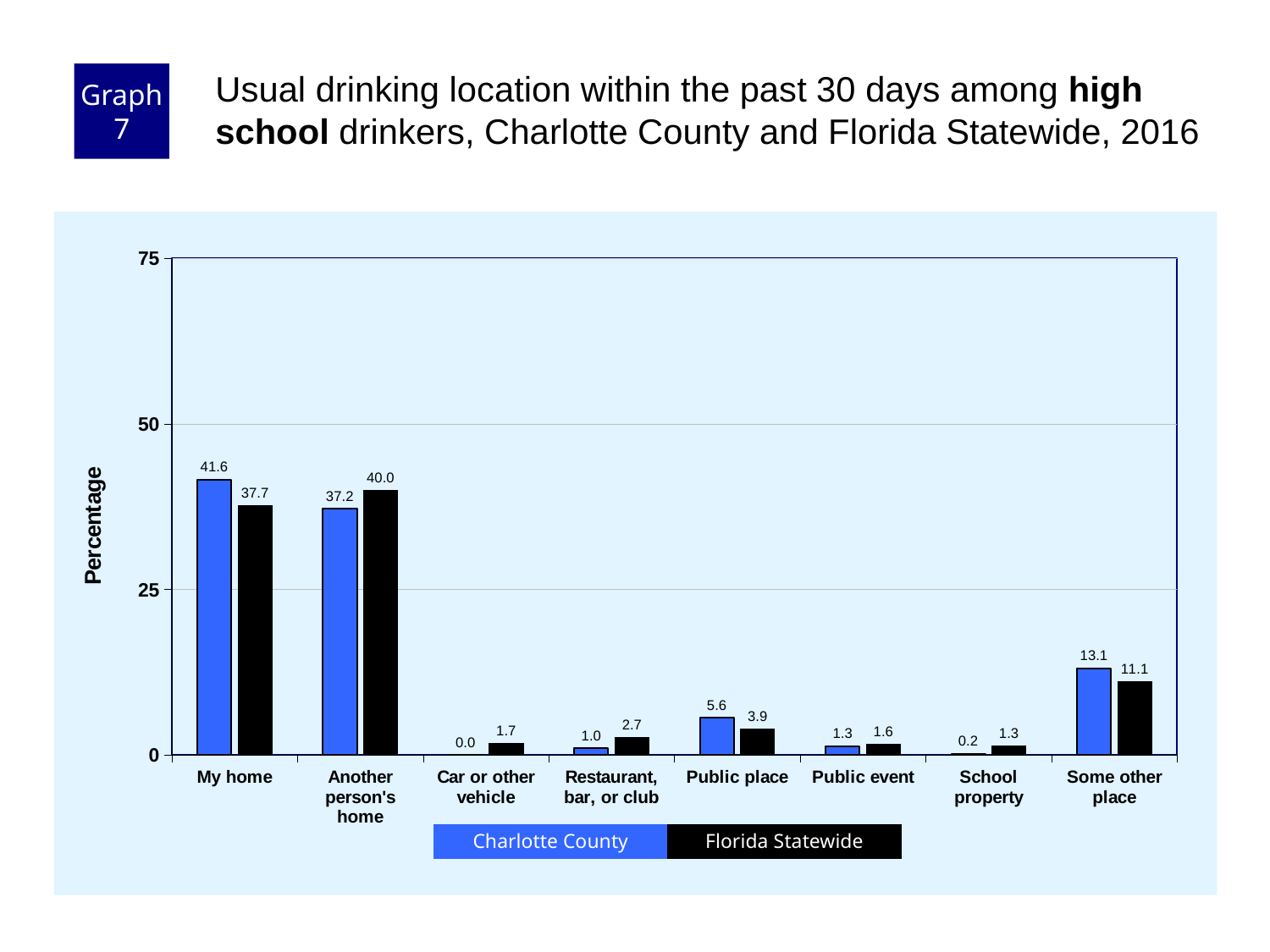
What kind of chart is shown? bar chart Which is larger for Public place: Charlotte County or Florida Statewide? Charlotte County What is the Florida Statewide value for Another person's home? 40.0 What is the label of the y axis? Percentage How many series does the legend list? 2 Is the Florida Statewide value for Another person's home greater or less than 25? greater Which category has the highest Charlotte County value? My home Which category has the lowest Charlotte County value? Car or other vehicle What is the Charlotte County value for Some other place? 13.1 What is the Charlotte County value for My home? 41.6 What is the difference between the Charlotte County and Florida Statewide values for My home? 3.9 How many categories are shown on the x axis? 8